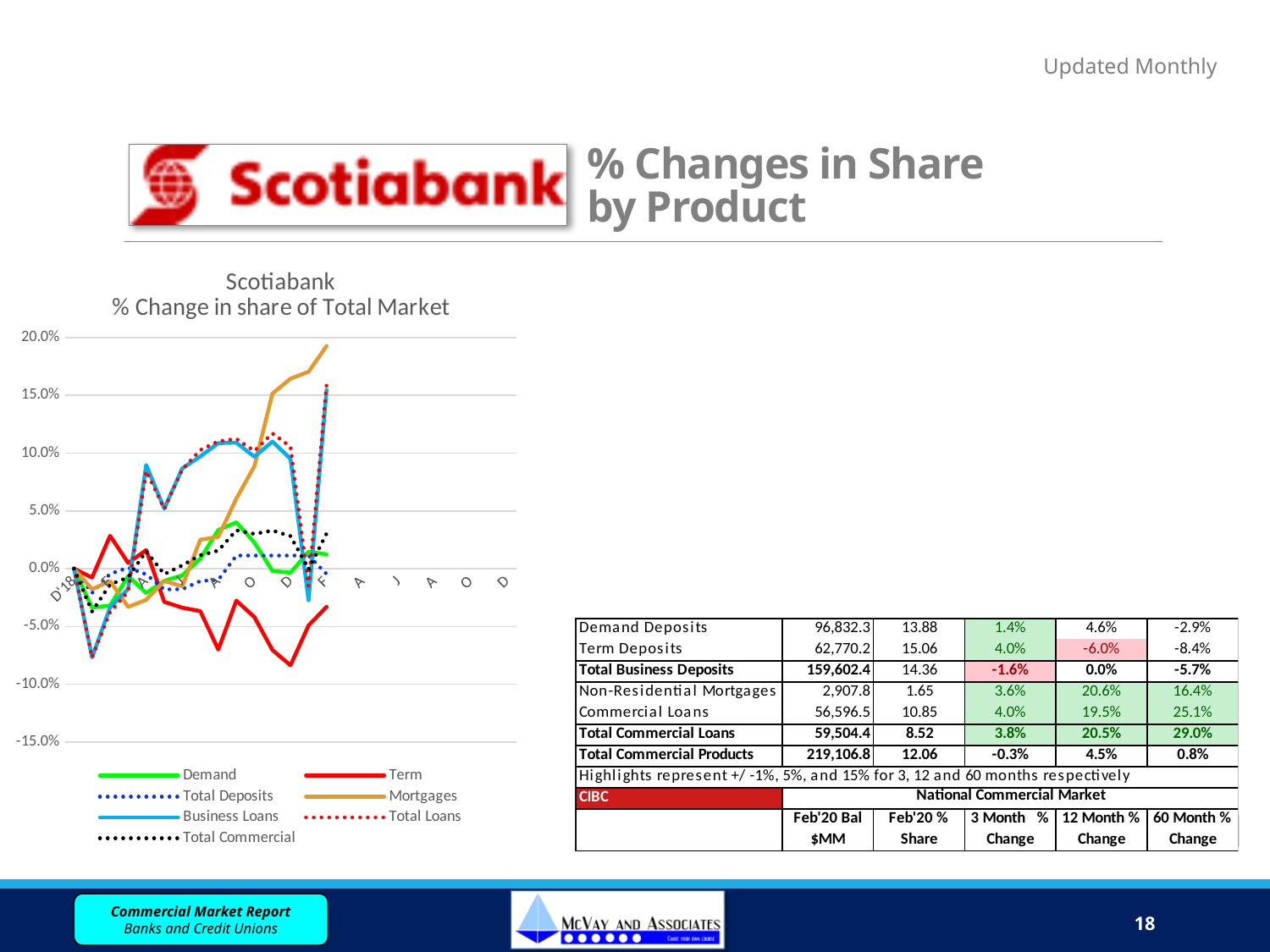
Is the final plotted value for Mortgages greater or less than 15.0%? greater Which colour is used for the Mortgages series in the chart? Orange What is the title of the chart? Scotiabank % Change in share of Total Market Does the Mortgages series generally rise or fall across the plotted period? Rise Which series reaches the highest value on the chart? Mortgages Is the highest plotted value for Business Loans greater or less than 5.0%? greater What is the highest value shown on the vertical axis of the chart? 20.0% How many series does the chart legend list? 7 At the end of the plotted period, which is higher: Mortgages or Demand? Mortgages Is the lowest plotted value for Term greater or less than -5.0%? less What kind of chart is shown on the slide? Line chart